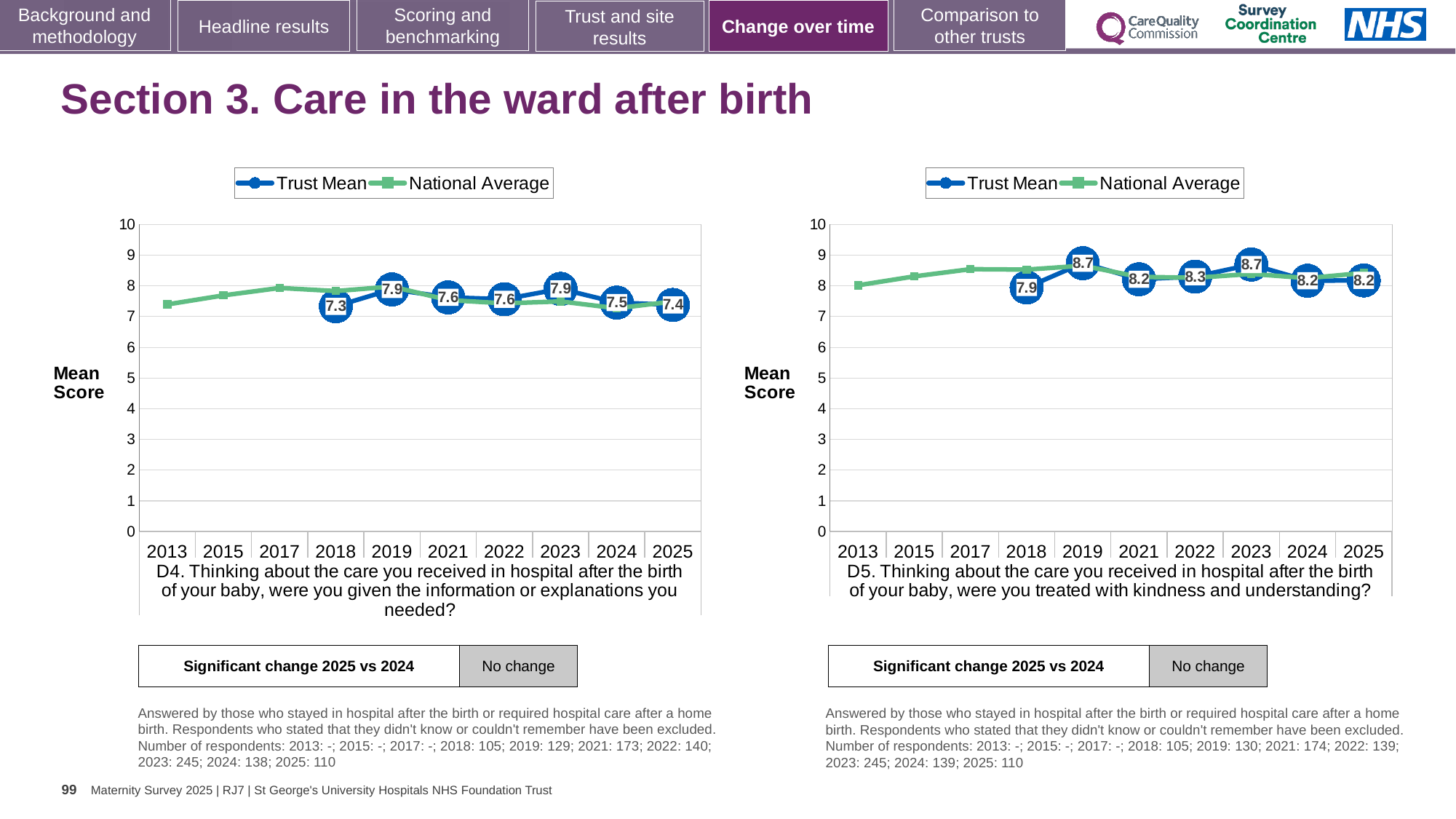
On the D4 chart (left), what is the Trust Mean score for 2018? 7.3 On the D4 chart (left), is the National Average value for 2013 greater or less than 8? less On the D4 chart (left), what is the difference between the Trust Mean scores for 2019 and 2018? 0.6 On the D5 chart (right), which is larger, the Trust Mean score for 2023 or for 2024? 2023 How many series does the legend of the D4 chart (left) list? 2 On the D5 chart (right), what is the Trust Mean score for 2022? 8.3 On the D4 chart (left), what is the Trust Mean score for 2025? 7.4 On the D5 chart (right), which year has the lowest Trust Mean score? 2018 How many years are shown on the x axis of the D5 chart (right)? 10 On the D5 chart (right), what is the Trust Mean score for 2025? 8.2 On the D5 chart (right), what is the difference between the Trust Mean scores for 2019 and 2018? 0.8 On the D4 chart (left), which year has the lowest Trust Mean score? 2018